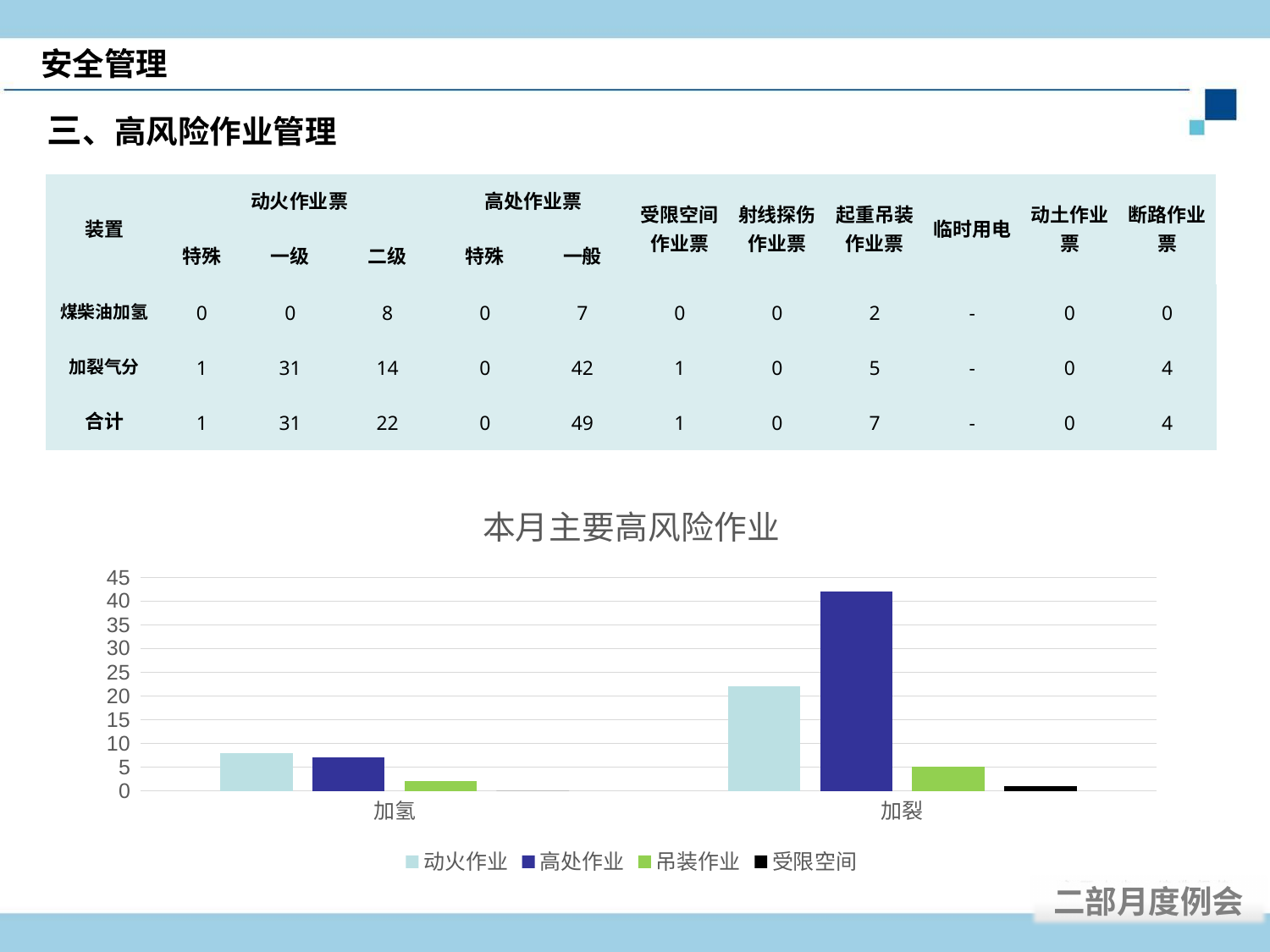
Which series has the tallest bar for 加裂? 高处作业 How many series does the chart legend list? 4 Is the value of 动火作业 for 加氢 greater or less than 10? less What kind of chart is shown on the slide? bar chart Which is larger for 加裂: 吊装作业 or 受限空间? 吊装作业 Which series has the tallest bar for 加氢? 动火作业 How many categories are shown on the x axis of the chart? 2 Which is larger: 高处作业 for 加氢 or 高处作业 for 加裂? 加裂 Which colour represents 受限空间 in the chart legend? black Is the value of 高处作业 for 加裂 greater or less than 40? greater Is the value of 动火作业 for 加裂 greater or less than 20? greater What is the title of the chart? 本月主要高风险作业